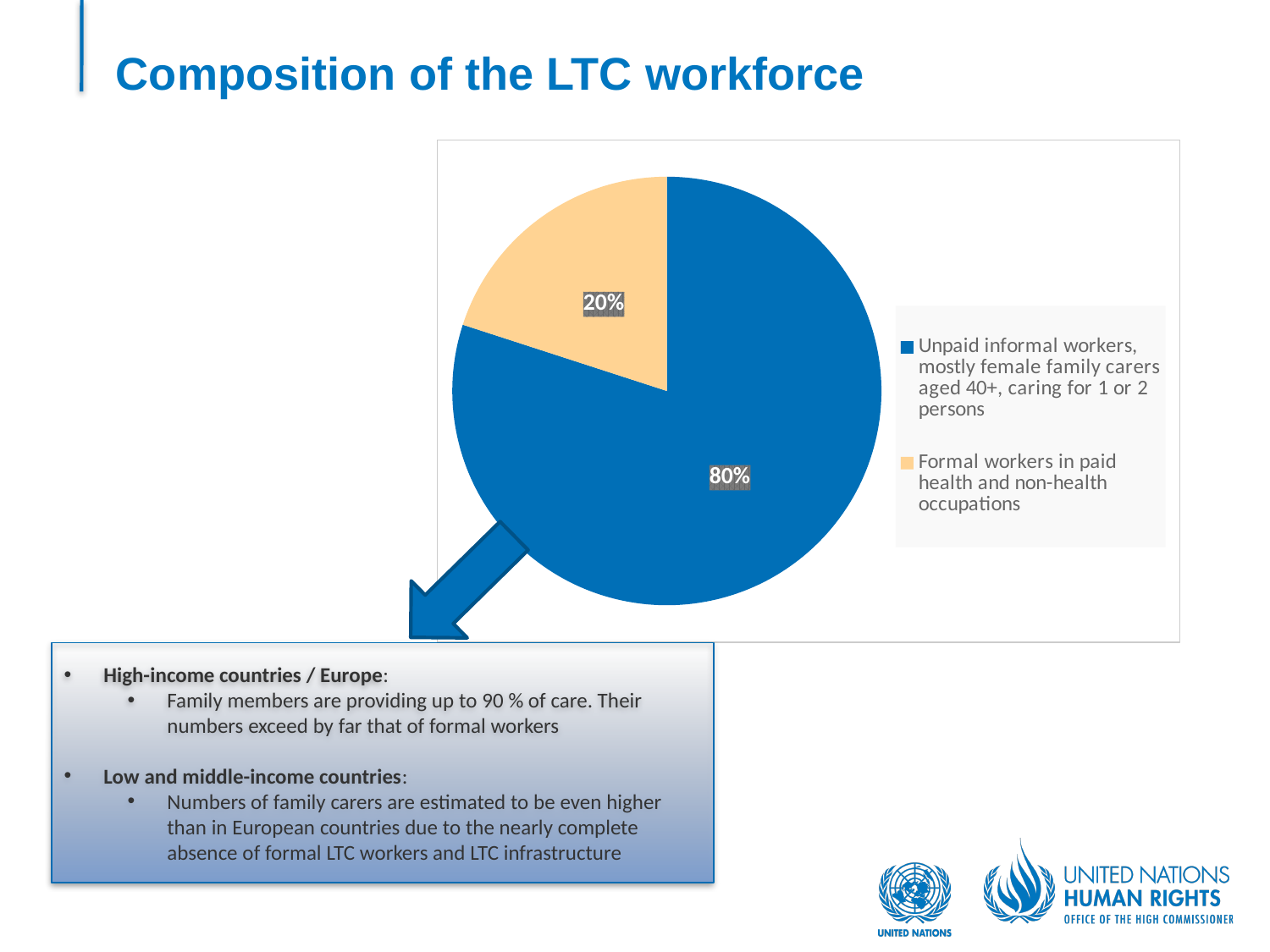
Which category has the smallest share of the pie? Formal workers in paid health and non-health occupations What kind of chart is shown on the slide? pie chart How many slices does the pie chart have? 2 What is the difference in percentage points between the unpaid informal workers slice and the formal workers slice? 60 What colour is the slice representing unpaid informal workers? blue Which is larger: the share of unpaid informal workers or the share of formal workers? Unpaid informal workers What colour is the slice representing formal workers in paid health and non-health occupations? light orange What share of the LTC workforce is made up of formal workers in paid health and non-health occupations? 20% Which category has the largest share of the pie? Unpaid informal workers, mostly female family carers aged 40+, caring for 1 or 2 persons What share of the LTC workforce is made up of unpaid informal workers? 80% How many entries does the legend list? 2